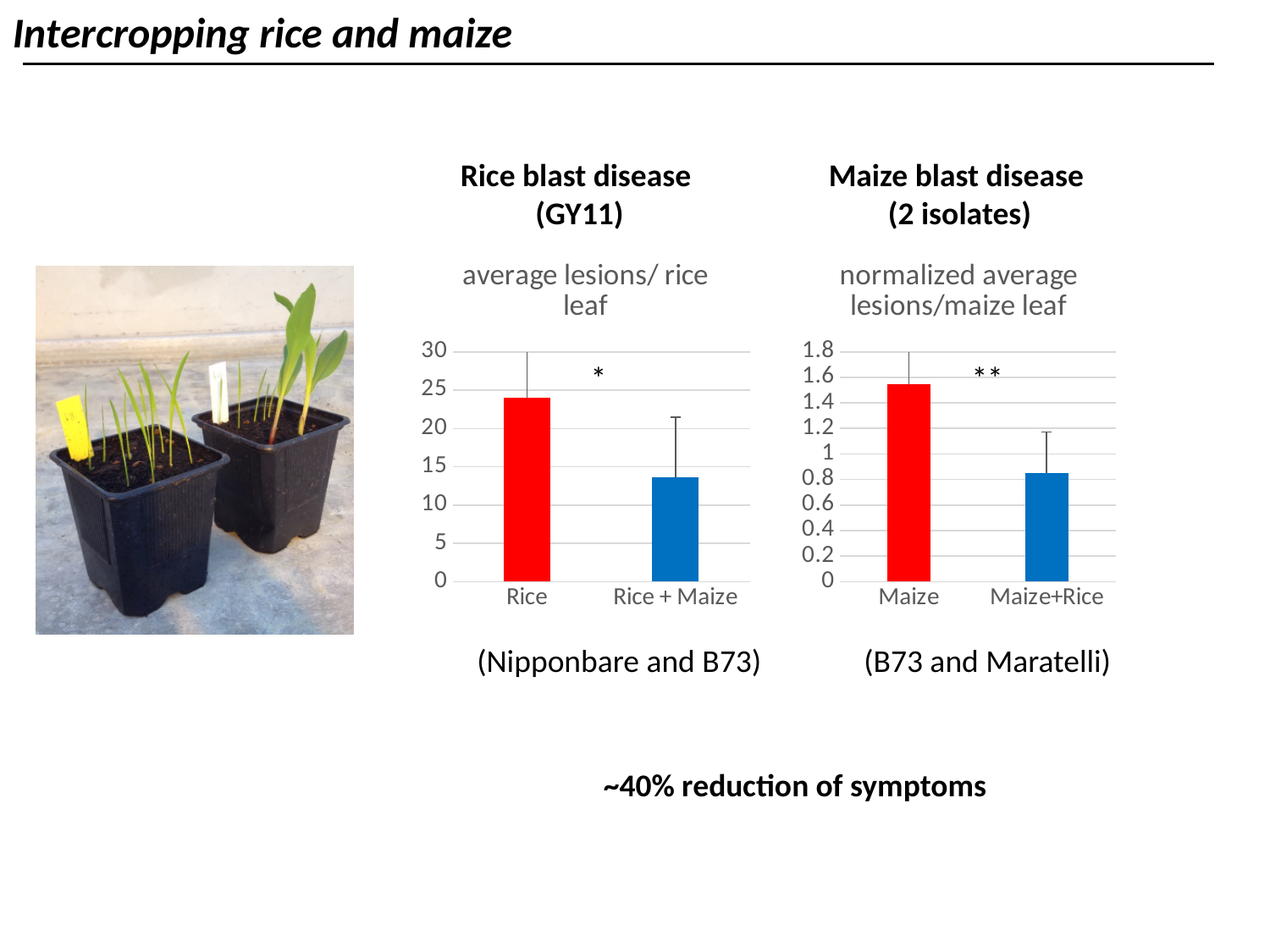
In the chart titled "average lesions/ rice leaf", which category has the lower value? Rice + Maize In the chart titled "normalized average lesions/maize leaf", is the value for Maize+Rice greater or less than 1? less In the chart titled "average lesions/ rice leaf", is the value for Rice greater or less than 20? greater What kind of chart is the chart titled "normalized average lesions/maize leaf"? bar chart In the chart titled "normalized average lesions/maize leaf", is the value for Maize larger or smaller than the value for Maize+Rice? larger In the chart titled "average lesions/ rice leaf", which category has the higher value? Rice In the chart titled "average lesions/ rice leaf", is the value for Rice + Maize greater or less than 15? less In the chart titled "normalized average lesions/maize leaf", which category has the higher value? Maize How many categories are shown on the x axis of the chart titled "average lesions/ rice leaf"? 2 What is the title of the left chart on the slide? average lesions/ rice leaf In the chart titled "normalized average lesions/maize leaf", what colour is the bar for Maize+Rice? blue